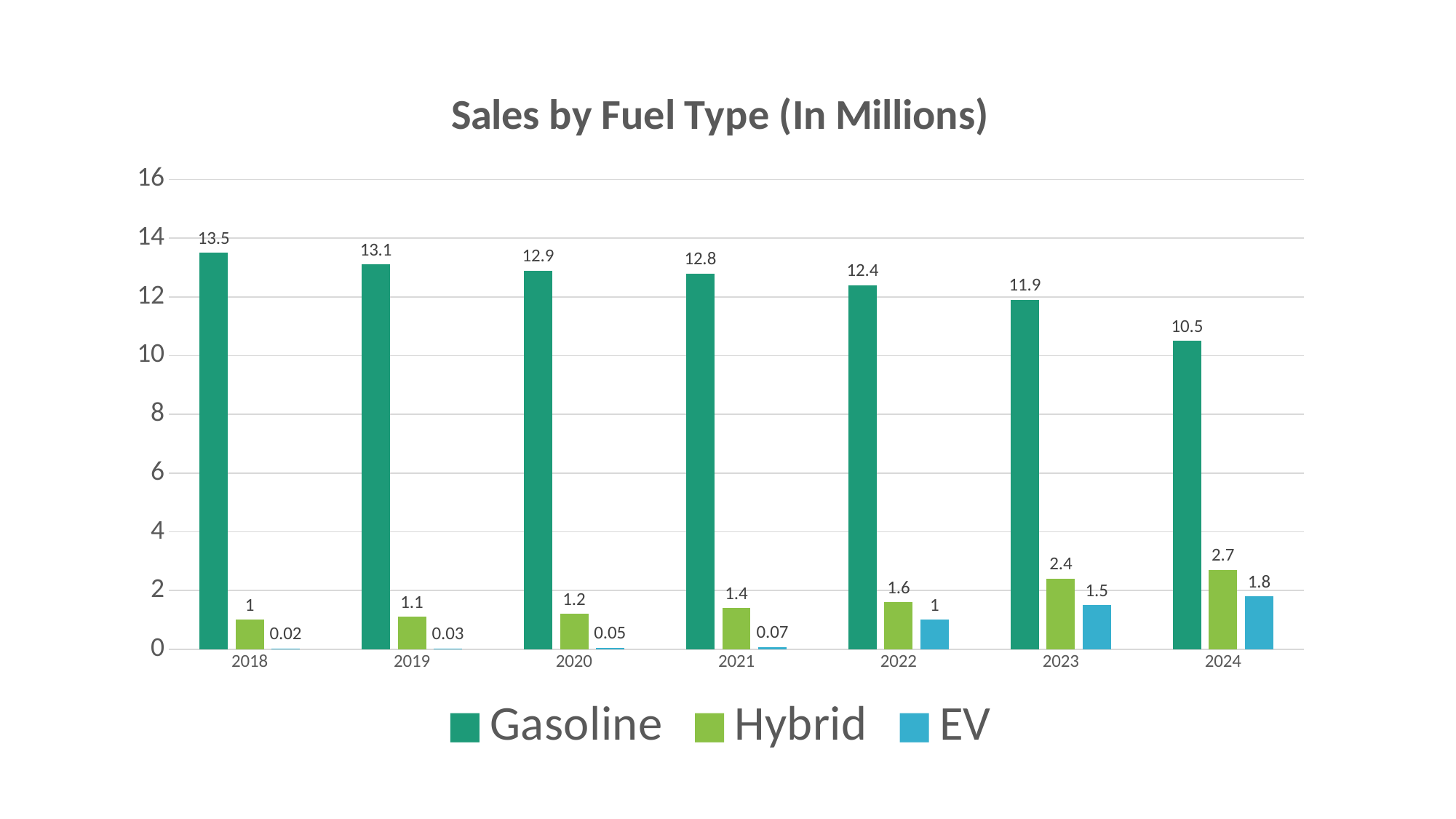
What kind of chart is shown? bar chart Is the Gasoline value for 2024 greater or less than 12? less What is the difference between the Gasoline values for 2018 and 2024? 3 In which year is the Gasoline value highest? 2018 How many years are shown on the x axis? 7 What is the Hybrid value for 2020? 1.2 What is the Gasoline value for 2021? 12.8 What is the EV value for 2023? 1.5 How many series does the legend list? 3 Do the Gasoline values rise or fall from 2018 to 2024? fall Which is larger, the Hybrid value for 2024 or the EV value for 2024? Hybrid In which year is the EV value lowest? 2018